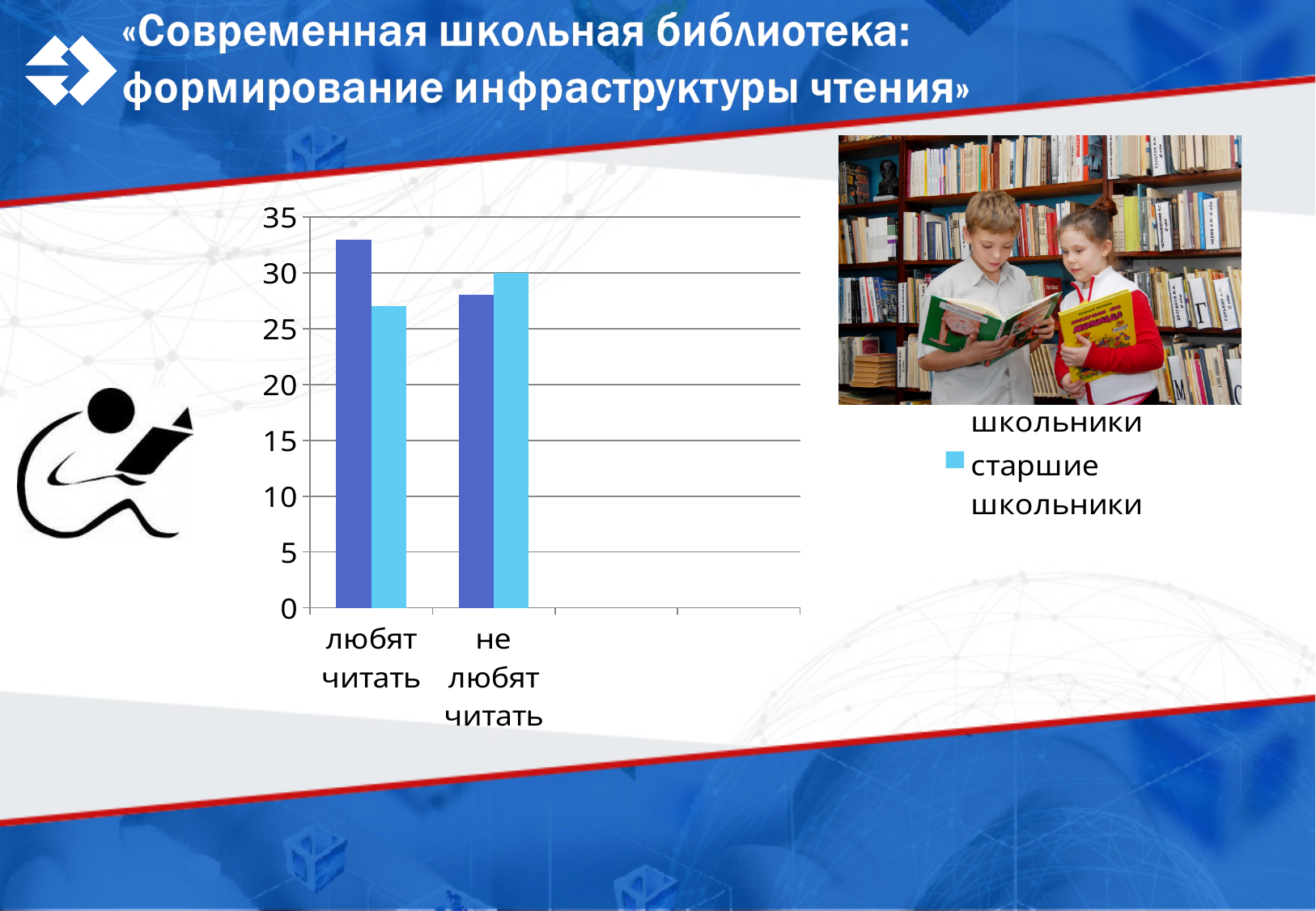
Is the value of the dark blue series for "не любят читать" greater or less than 25? greater Which bar is the tallest in the chart? the dark blue bar for "любят читать" In the "любят читать" category, which series has the larger value: the dark blue series or "старшие школьники"? the dark blue series What kind of chart is shown on the slide? bar chart What colour represents "старшие школьники" in the chart's legend? light blue For "старшие школьники", which category has the larger value: "любят читать" or "не любят читать"? не любят читать How many categories are shown on the x axis of the chart? 2 Is the value of the dark blue series for "любят читать" greater or less than 30? greater Is the value of the dark blue series for "не любят читать" greater or less than 30? less What is the value for "старшие школьники" in the "не любят читать" category? 30 How many series does the chart's legend list? 2